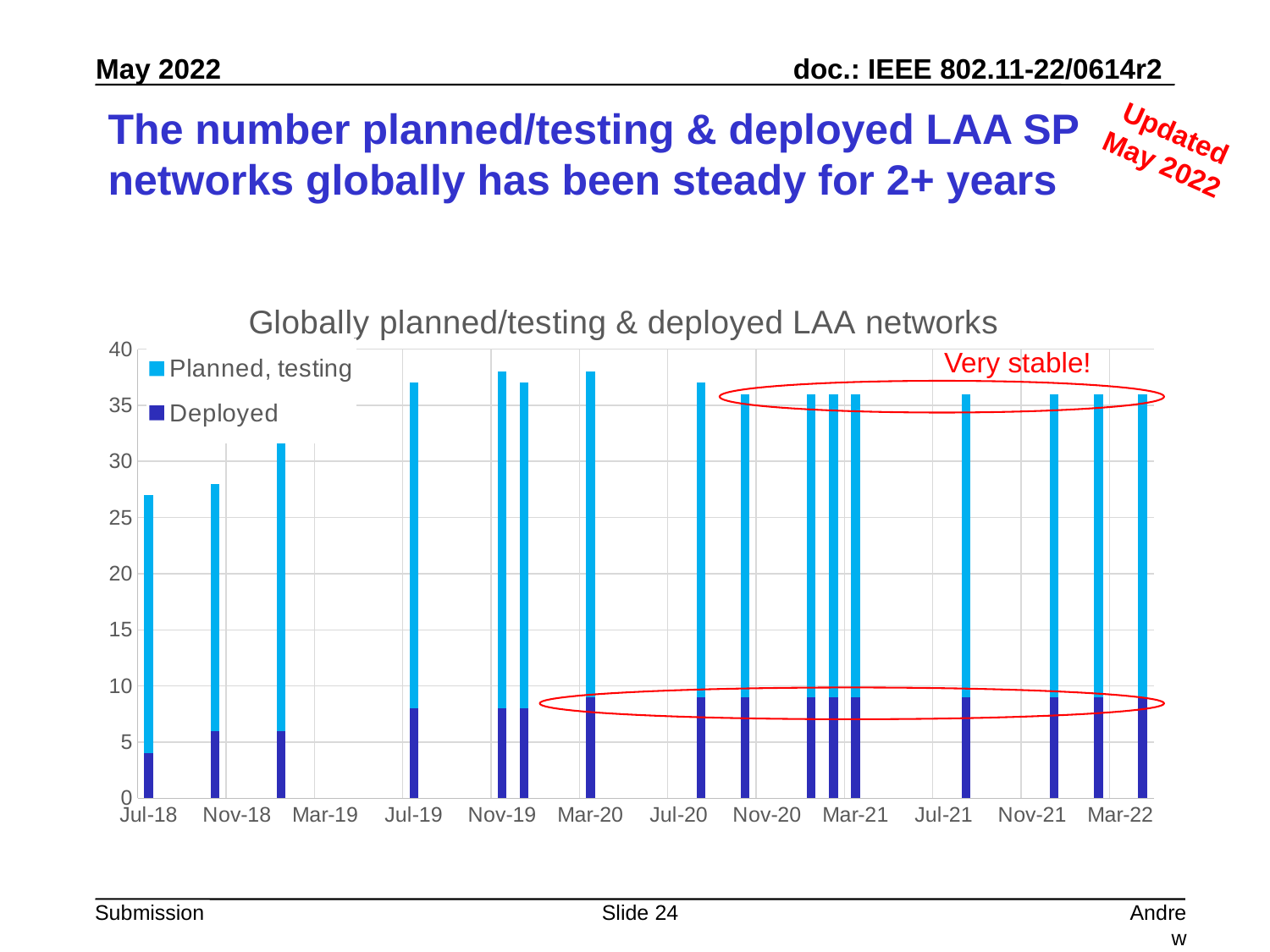
Which two series are listed in the chart's legend? Planned, testing; Deployed Which bar has the larger total, Jul-18 or Jul-19? Jul-19 Is the total height of the Nov-18 bar greater or less than 25? greater Is the Deployed value for Mar-20 greater or less than 5? greater What is the title of the chart? Globally planned/testing & deployed LAA networks Is the total height of the Jul-18 bar greater or less than 30? less How many series does the chart's legend list? 2 Which has the larger Deployed value, Jul-18 or Mar-20? Mar-20 What kind of chart is shown on the slide? Stacked bar chart Do the total bar heights rise or fall from Jul-18 to Jul-19? rise